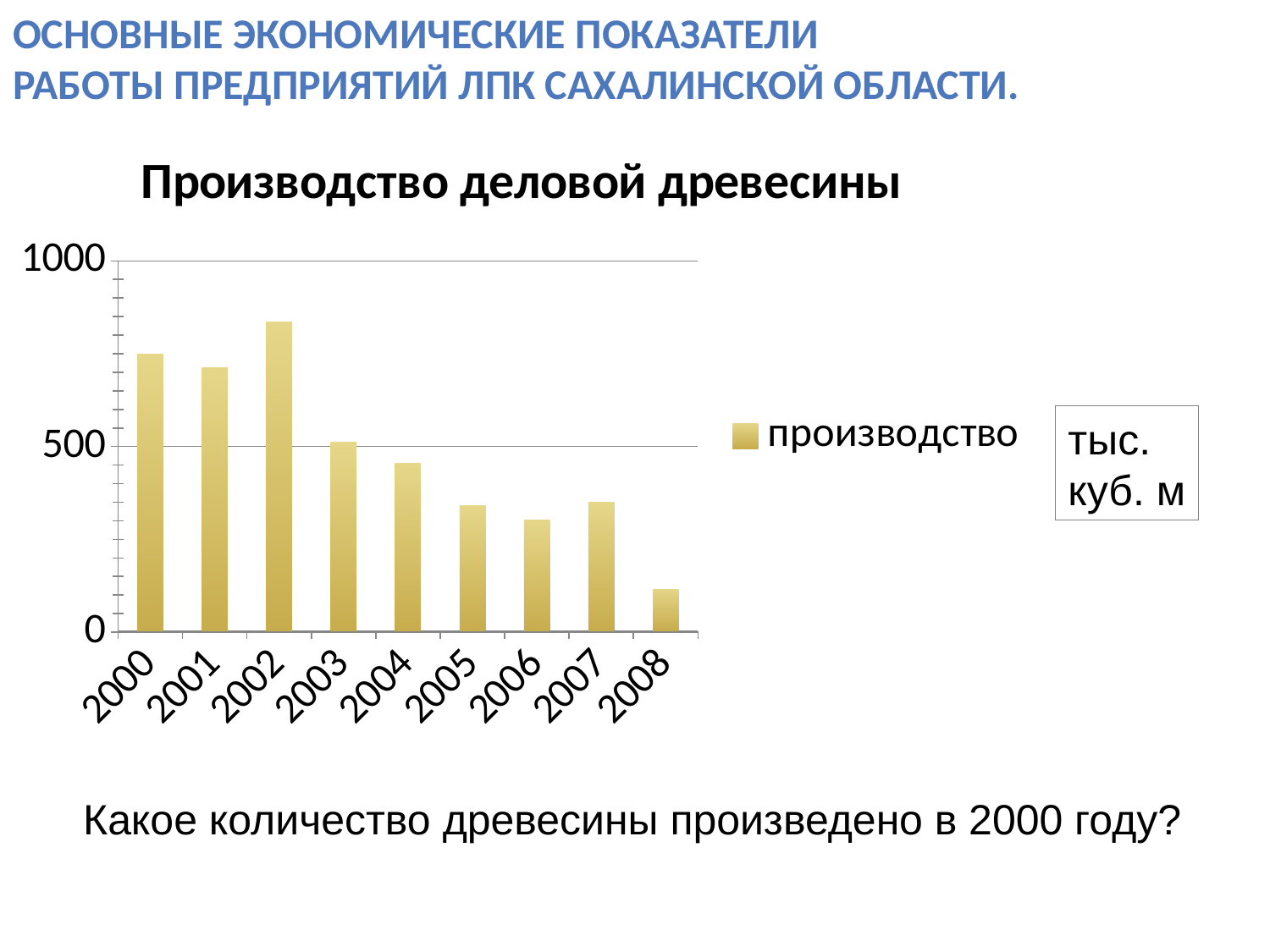
Is the value for 2002 greater or less than 1000? less How many series does the chart legend list? 1 What kind of chart is shown on the slide? bar chart Do the values generally rise or fall from 2000 to 2008? fall What is the name of the series listed in the chart legend? производство How many years are shown on the x axis of the chart? 9 Which year has the larger value, 2002 or 2008? 2002 Is the value for 2005 greater or less than 500? less Is the value for 2008 greater or less than 500? less Which year has the lowest production value in the chart? 2008 Which year has the highest production value in the chart? 2002